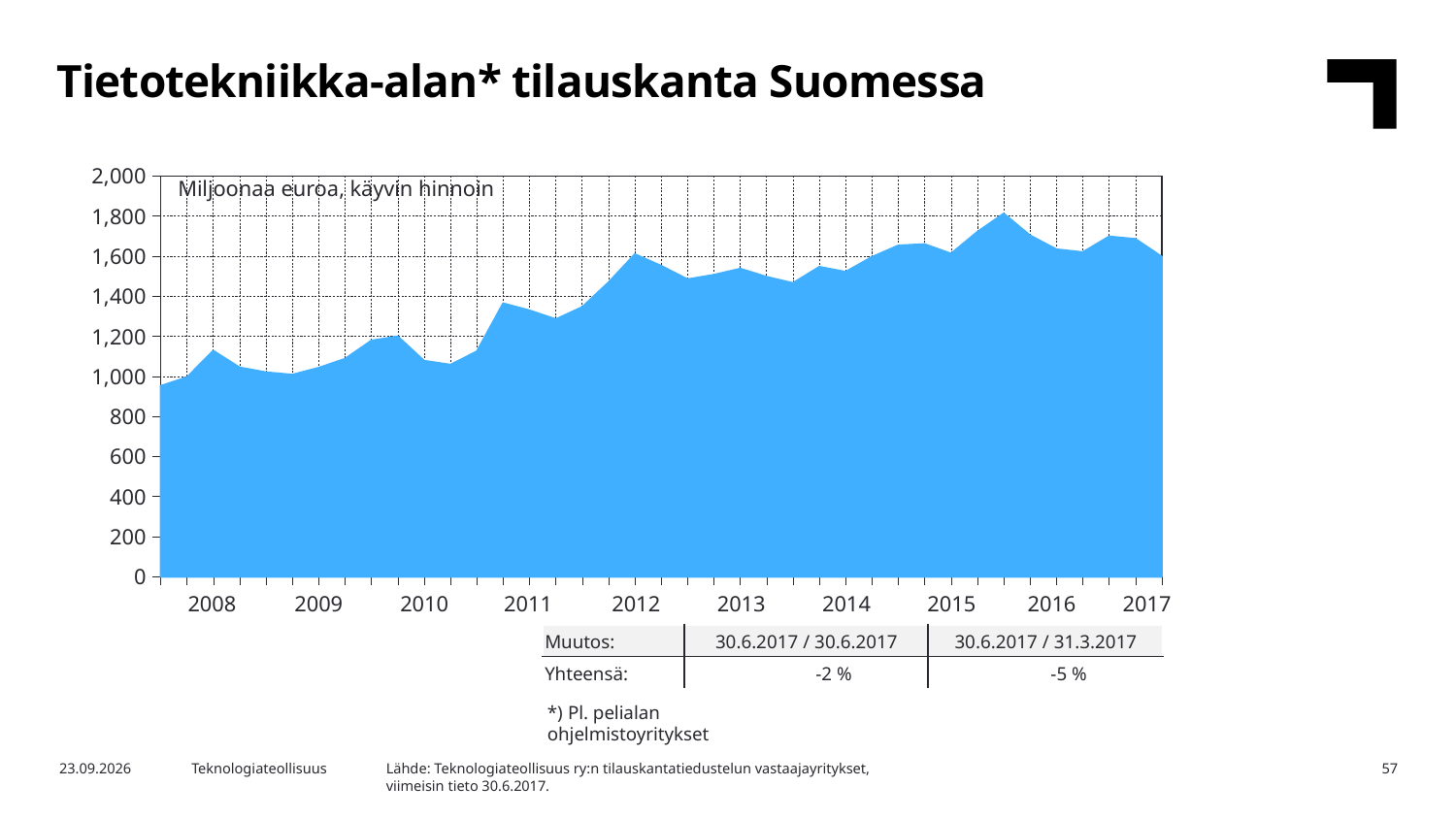
Which is larger, the value at 2012 or the value at 2010? 2012 What is the title of the slide's chart? Tietotekniikka-alan* tilauskanta Suomessa What kind of chart is shown on the slide? Area chart According to the table below the chart, what is the change (Yhteensä) for 30.6.2017 / 30.6.2017? -2 % Is the value at 2017 greater or less than 1,400? greater Is the lowest value on the chart greater or less than 1,200? less How many years are labelled on the x axis of the chart? 10 Which is larger, the value at 2017 or the value at 2008? 2017 Is the value at 2014 greater or less than 1,200? greater What unit label is printed inside the chart area? Miljoonaa euroa, käyvin hinnoin Overall, do the values rise or fall from 2008 to 2017? Rise